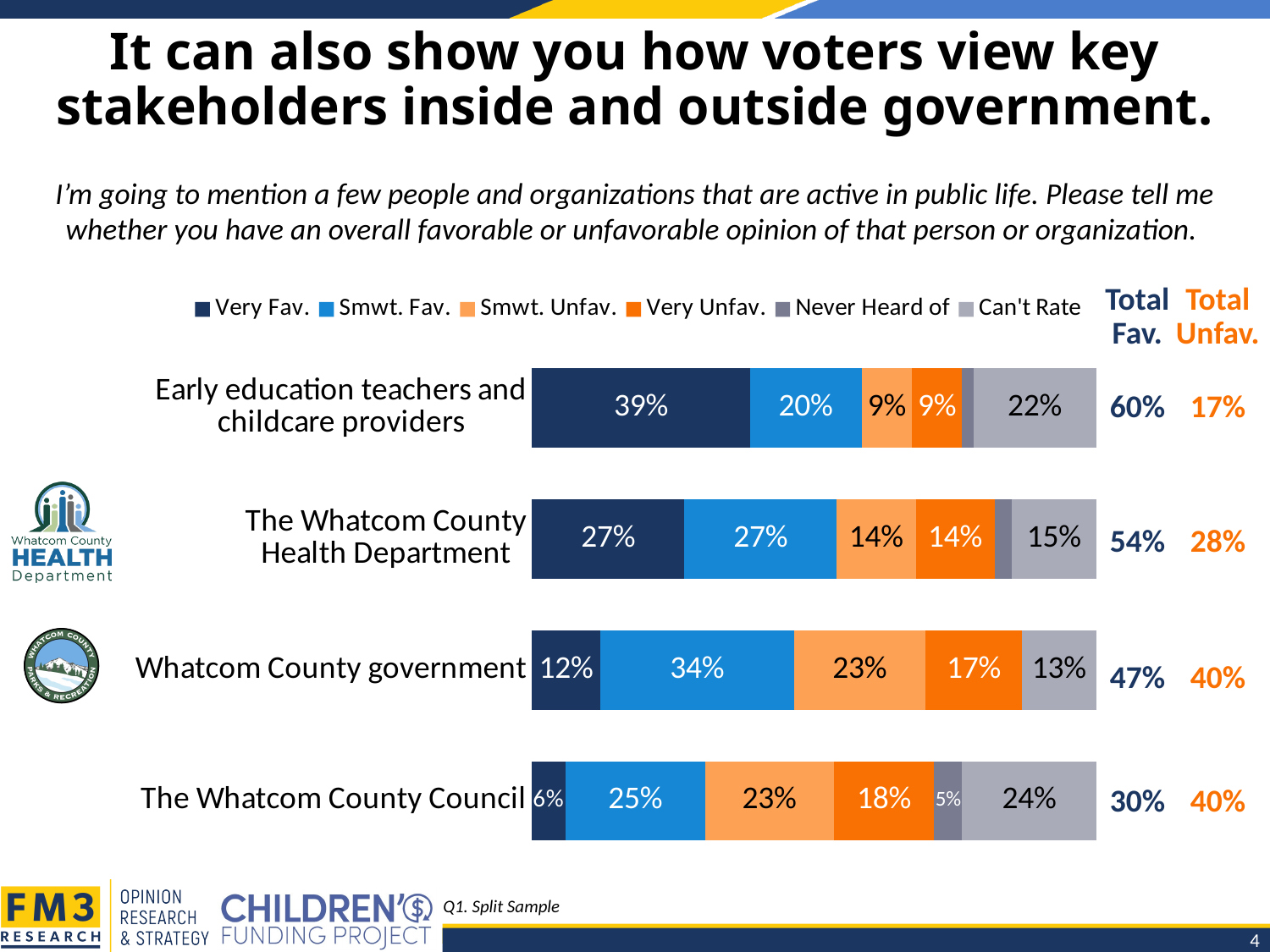
What is the Smwt. Fav. value for Whatcom County government? 34% What kind of chart is shown on the slide? Stacked bar chart What is the Very Fav. value for Early education teachers and childcare providers? 39% Which organization has the lowest Very Fav. value? The Whatcom County Council How many people or organizations are rated in the chart? 4 What is the Very Unfav. value for The Whatcom County Council? 18% Which organization has the highest Very Fav. value? Early education teachers and childcare providers What is the difference between the Very Fav. value for Early education teachers and childcare providers and the Very Fav. value for The Whatcom County Health Department? 12 percentage points What is the Total Fav. value shown for The Whatcom County Health Department? 54% How many series does the legend list? 6 What is the first entry in the chart's legend? Very Fav. Which has a larger Smwt. Unfav. value: Whatcom County government or The Whatcom County Health Department? Whatcom County government